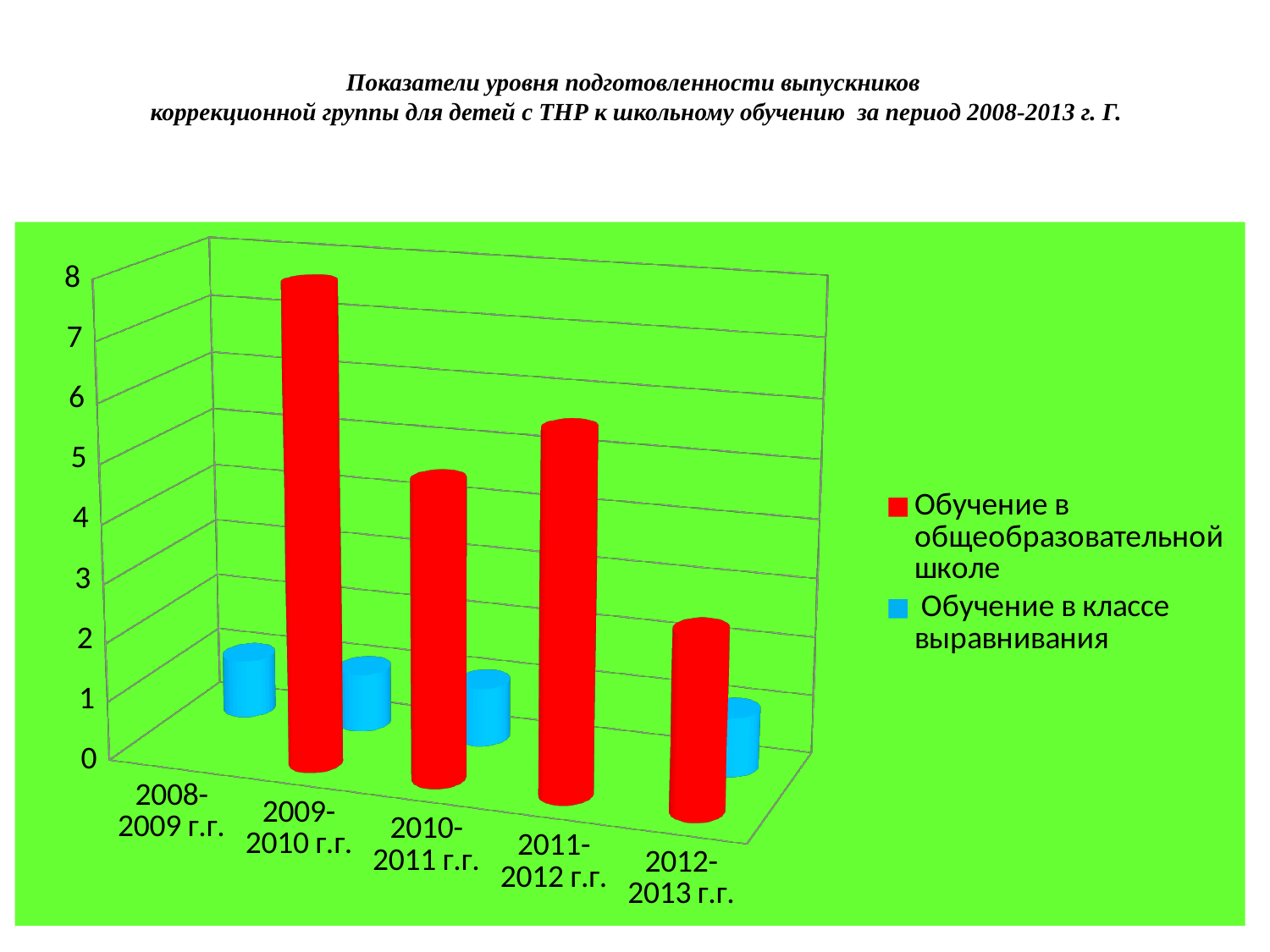
Which is larger for "Обучение в общеобразовательной школе": 2010-2011 г.г. or 2011-2012 г.г.? 2011-2012 г.г. Is the value for "Обучение в общеобразовательной школе" in 2011-2012 г.г. greater or less than 3? greater How many year periods are shown on the x axis? 5 Which period has the highest value for "Обучение в общеобразовательной школе"? 2009-2010 г.г. Which series is shown in red? Обучение в общеобразовательной школе Which is larger for "Обучение в общеобразовательной школе": 2009-2010 г.г. or 2012-2013 г.г.? 2009-2010 г.г. Is the value for "Обучение в общеобразовательной школе" in 2009-2010 г.г. greater or less than 6? greater Which colour represents "Обучение в классе выравнивания" in the legend? blue What kind of chart is shown on the slide? bar chart How many series does the legend list? 2 Among the periods with a red bar, which has the lowest value for "Обучение в общеобразовательной школе"? 2012-2013 г.г. Is the value for "Обучение в общеобразовательной школе" in 2012-2013 г.г. greater or less than 4? less